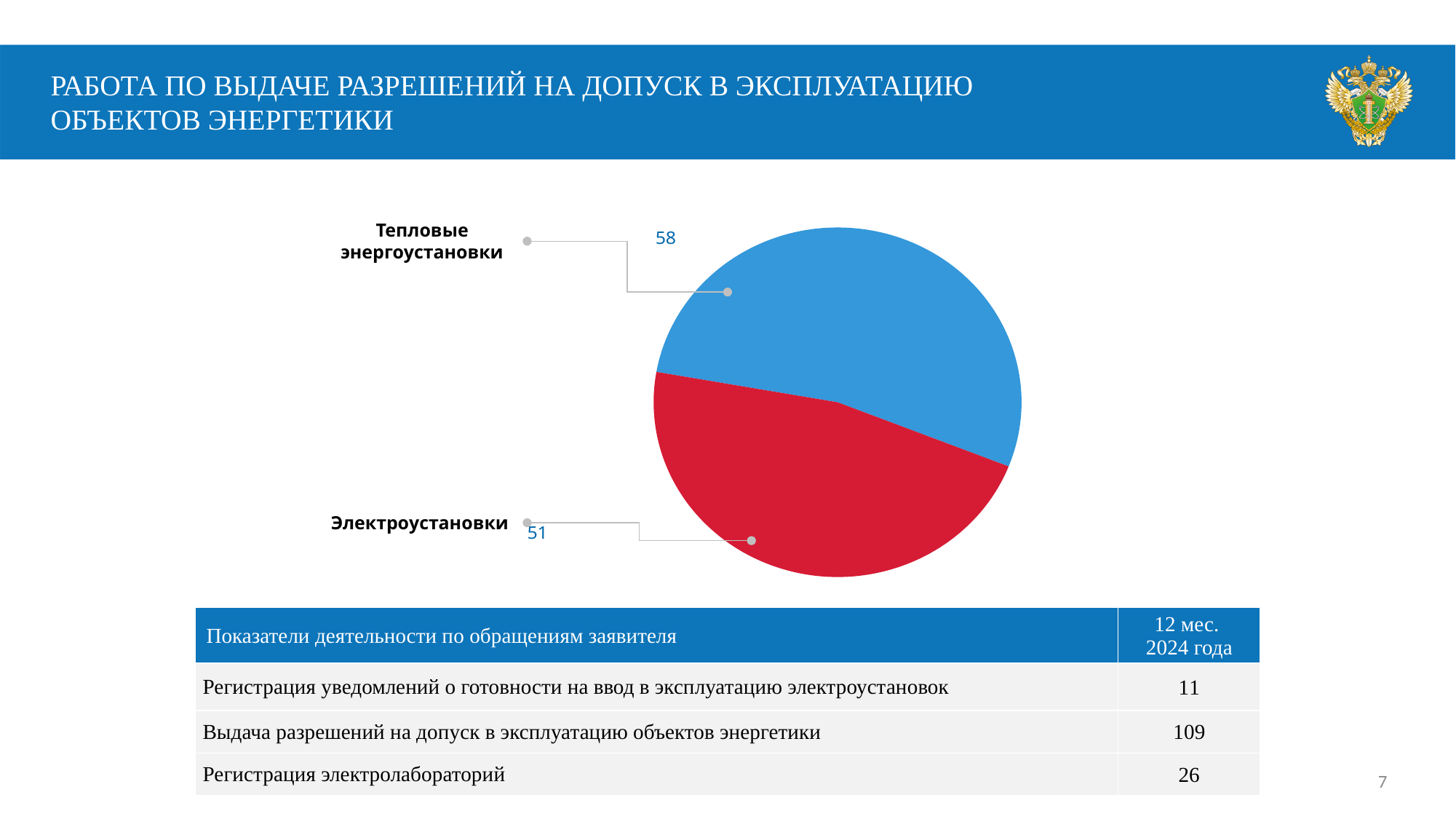
What kind of chart is shown on the slide? pie chart What share of the pie does Тепловые энергоустановки represent, to one decimal place? 53.2% What value is shown for Электроустановки in the pie chart? 51 Which category has the larger slice in the pie chart? Тепловые энергоустановки What is the total of the two values shown in the pie chart? 109 Which category has the smaller slice in the pie chart? Электроустановки How many categories are shown in the pie chart? 2 Is the value for Тепловые энергоустановки larger or smaller than the value for Электроустановки? larger What colour is the slice for Электроустановки in the pie chart? red What colour is the slice for Тепловые энергоустановки in the pie chart? blue What value is shown for Тепловые энергоустановки in the pie chart? 58 What is the difference between the values for Тепловые энергоустановки and Электроустановки? 7